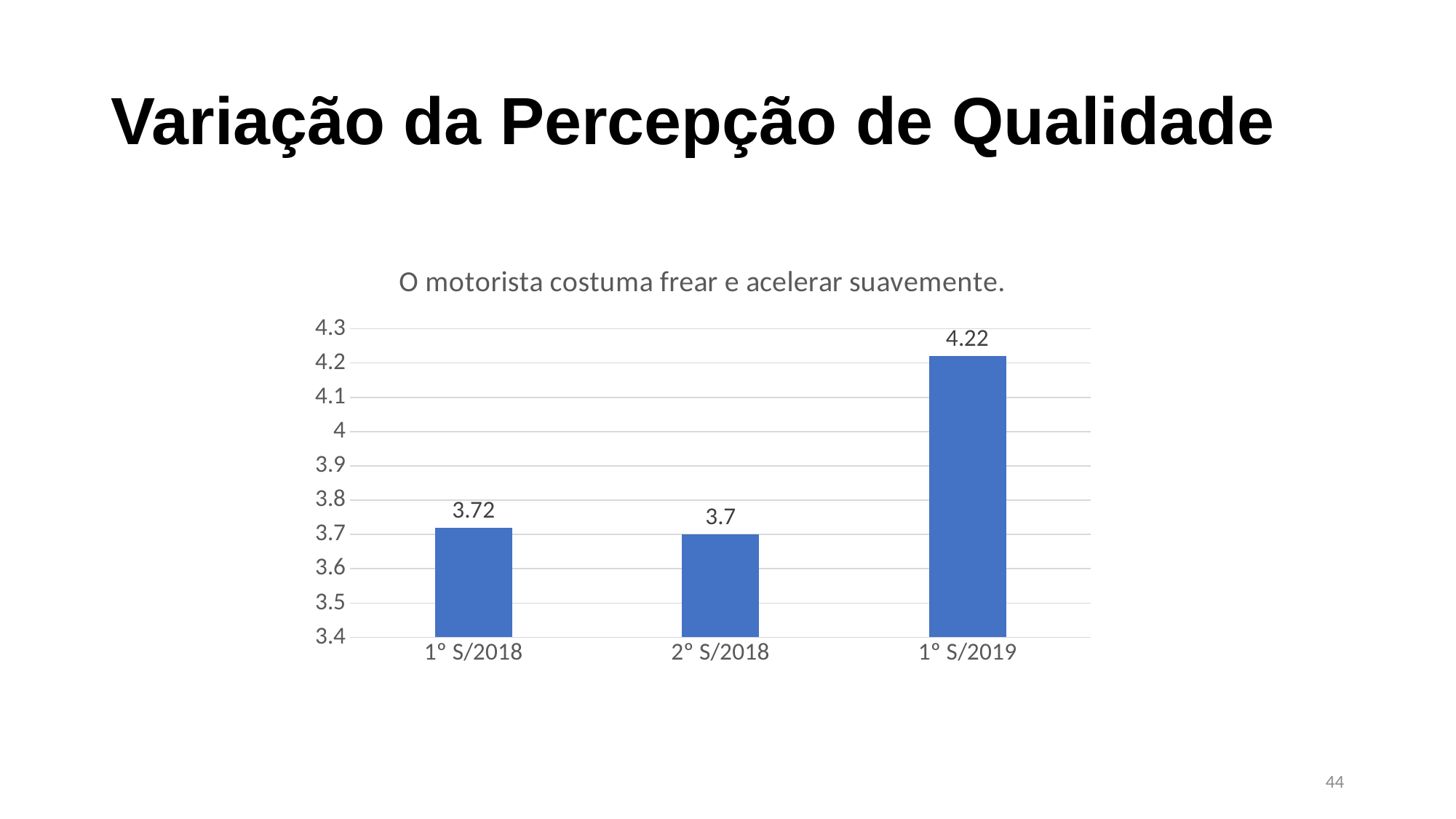
Which category has the lowest value? 2° S/2018 What is the difference between the values for 1° S/2019 and 2° S/2018? 0.52 What is the difference between the values for 1° S/2018 and 2° S/2018? 0.02 What is the value for 1° S/2019? 4.22 Which category has the highest value? 1° S/2019 Which is larger, the value for 1° S/2019 or the value for 1° S/2018? 1° S/2019 Is the value for 1° S/2019 greater or less than 4? greater What is the title of the chart? O motorista costuma frear e acelerar suavemente. How many categories are shown on the x axis? 3 What is the value for 1° S/2018? 3.72 What is the value for 2° S/2018? 3.7 What kind of chart is shown on the slide? bar chart